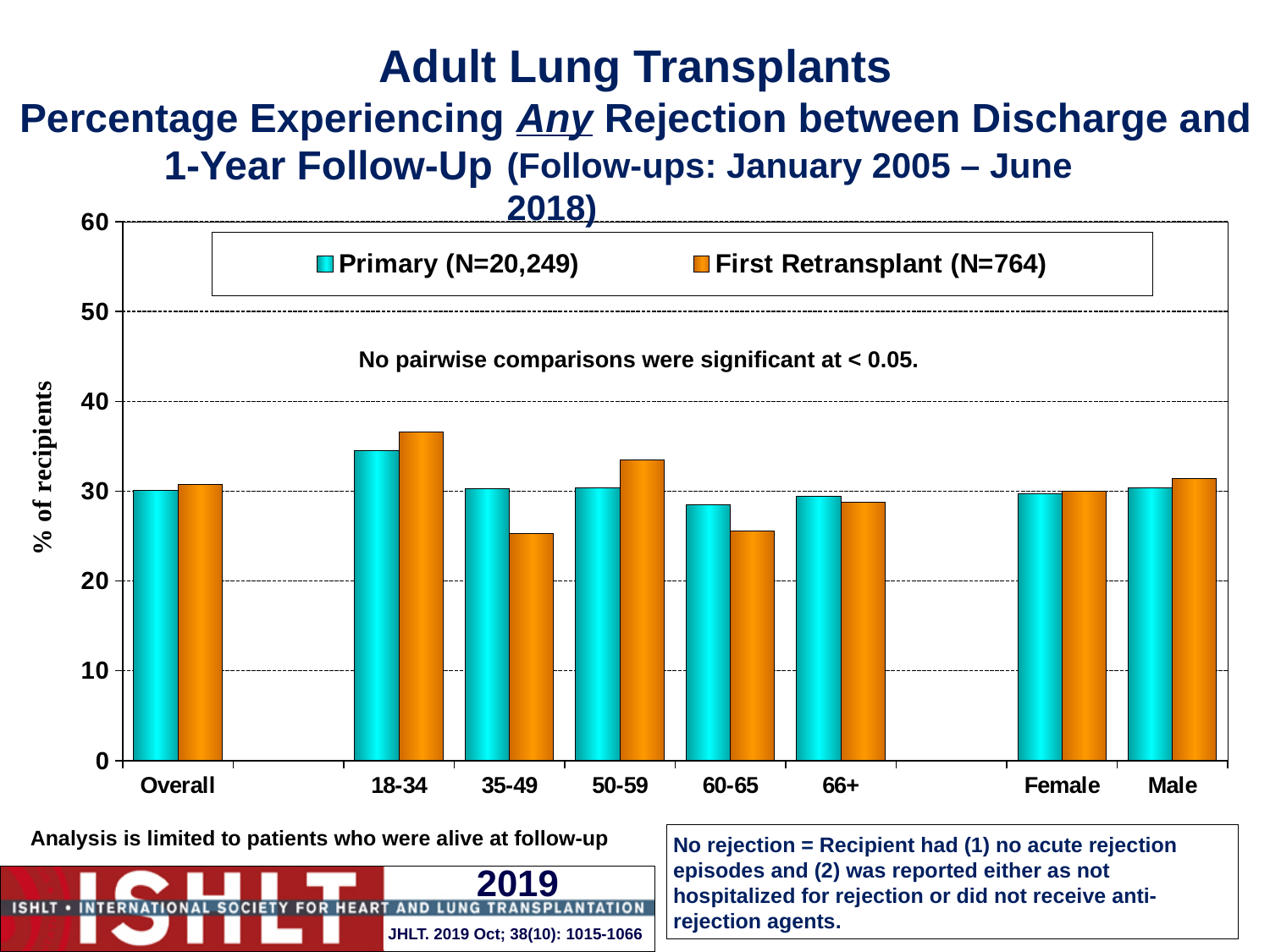
Is the Primary value for 18-34 greater or less than 30? greater Which category has the highest value for the First Retransplant series? 18-34 Is the First Retransplant value for 18-34 greater or less than 40? less What is the label of the y axis? % of recipients What kind of chart is shown on the slide? bar chart For the 35-49 age group, which series has the larger value, Primary or First Retransplant? Primary Is the First Retransplant value for 35-49 greater or less than 30? less For the 50-59 age group, which series has the larger value, Primary or First Retransplant? First Retransplant How many categories are shown on the x axis? 8 Which category has the highest value for the Primary series? 18-34 How many series does the legend list? 2